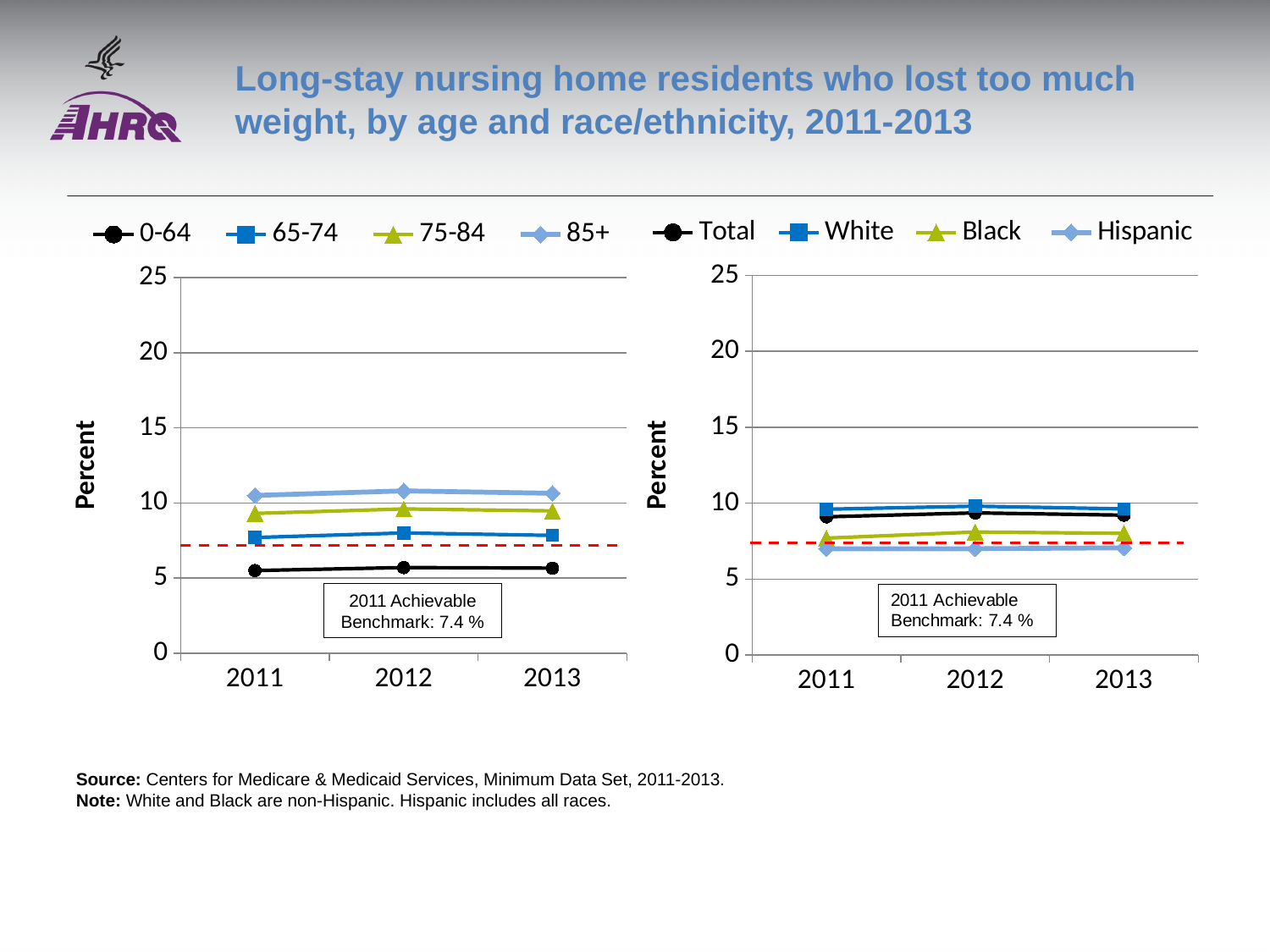
How many years are shown on the x axis of the right chart (by race/ethnicity)? 3 In the left chart (by age), is the value for 75-84 in 2012 greater or less than 5? greater In the left chart (by age), which age group has the lowest percentage in 2012? 0-64 In the left chart (by age), is the value for 0-64 in 2011 greater or less than 10? less In the right chart (by race/ethnicity), which group has the lowest percentage in 2011? Hispanic How many series does the legend of the right chart (by race/ethnicity) list? 4 In the left chart (by age), which age group has the highest percentage in 2013? 85+ How many series does the legend of the left chart (by age) list? 4 In the right chart (by race/ethnicity), which group has the highest percentage in 2012? White In the left chart (by age), which is larger in 2013, the value for 85+ or the value for 0-64? 85+ What kind of chart is the left chart (by age)? line chart What is the 2011 Achievable Benchmark shown on the charts? 7.4 %